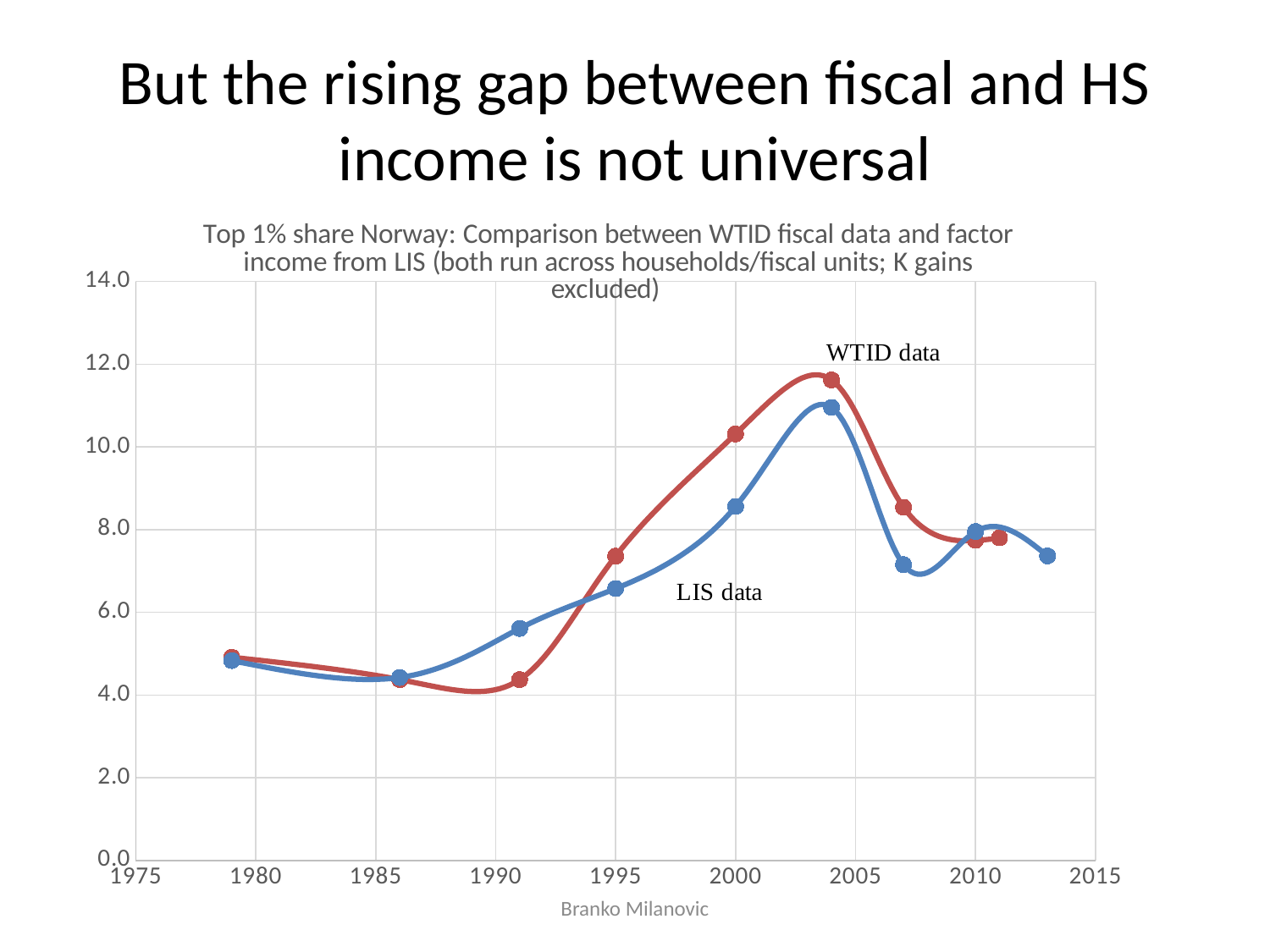
Between 1991 and 2004, does the WTID data series rise or fall? rise What kind of chart is shown on the slide? line chart Is the WTID data value for 1991 greater or less than 6.0? less Is the WTID data value for 2004 greater or less than 10.0? greater What are the names of the two series labelled on the chart? WTID data and LIS data How many data series are plotted on the chart? 2 In 2000, which series has the higher value, WTID data or LIS data? WTID data Is the LIS data value for 2000 greater or less than 8.0? greater In which year does the LIS data series reach its highest value? 2004 In 1995, which series has the higher value, WTID data or LIS data? WTID data In which year does the WTID data series reach its highest value? 2004 Which country does the chart title say the top 1% share refers to? Norway